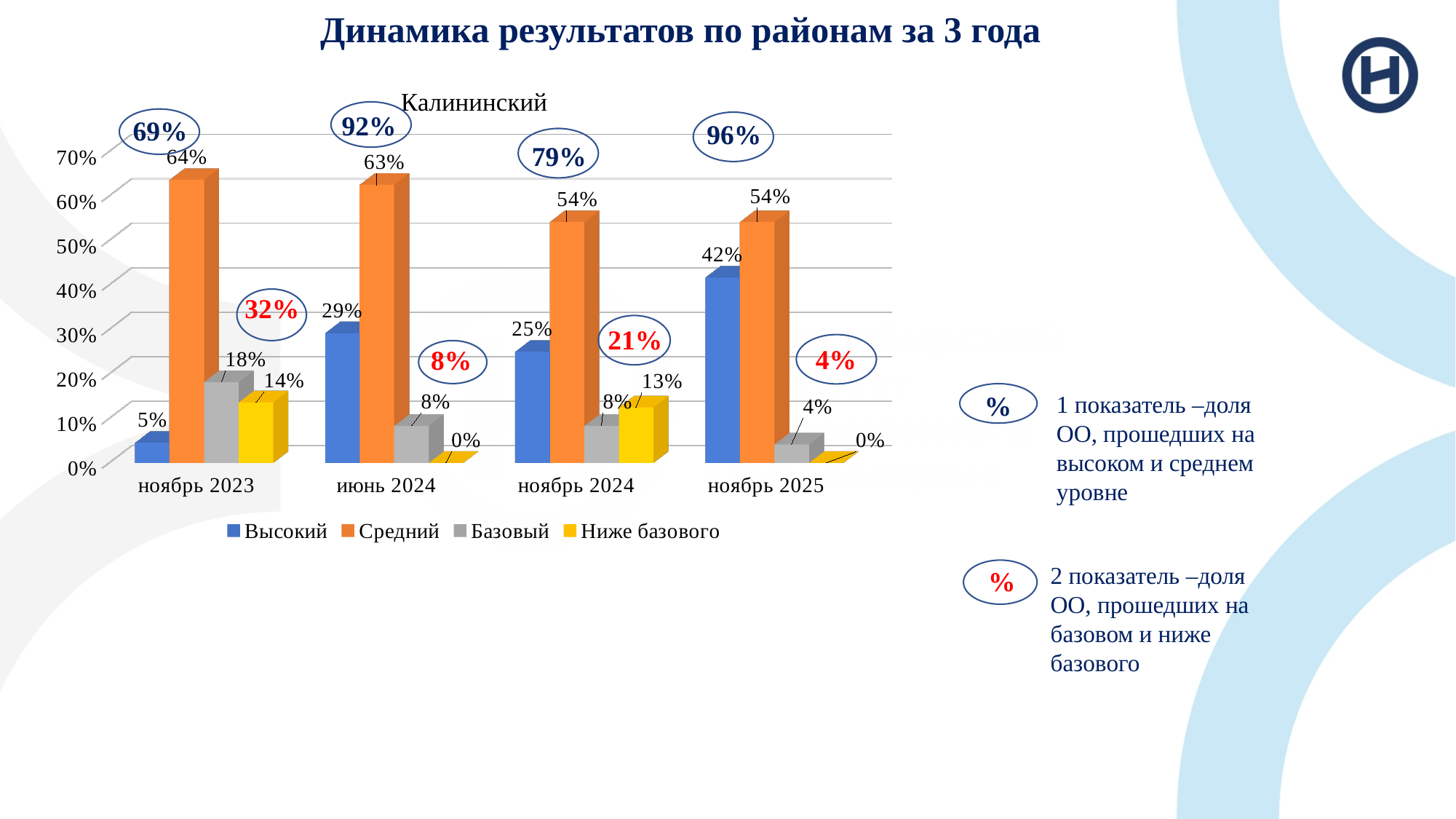
What is the title of the chart? Калининский What kind of chart is shown? bar chart In which period is the Высокий value the lowest? ноябрь 2023 What is the value for Ниже базового in ноябрь 2024? 13% In which period is the Высокий value the highest? ноябрь 2025 What is the value for Высокий in ноябрь 2025? 42% What is the value for Средний in ноябрь 2023? 64% Which is larger: Базовый in ноябрь 2023 or Базовый in ноябрь 2025? ноябрь 2023 How many series does the legend list? 4 What is the difference between the Средний values for ноябрь 2023 and ноябрь 2024? 10% How many periods are shown on the x axis? 4 What is the value for Базовый in июнь 2024? 8%